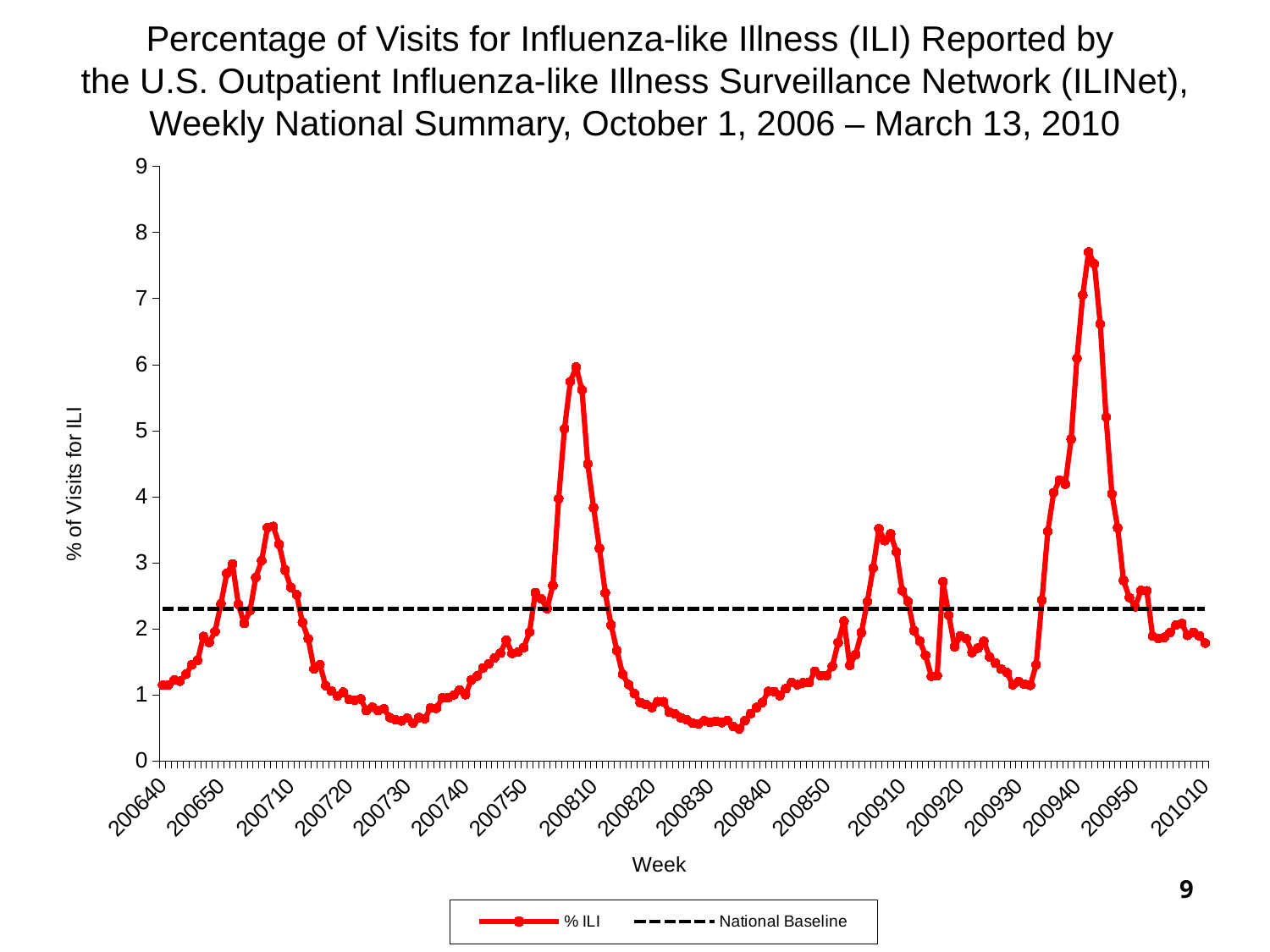
What kind of chart is shown on the slide? line chart What is the title of the vertical axis? % of Visits for ILI Around which x-axis week label does the % ILI line reach its highest value? 200940 Is the peak of the % ILI line near week 200710 greater or less than 4? less Around which x-axis week label does the % ILI line reach its lowest value? 200830 Between week 200810 and week 200830, does the % ILI line rise or fall? fall Which peak of the % ILI line is higher: the one near week 200810 or the one near week 200940? the one near week 200940 What are the two entries in the chart's legend? % ILI and National Baseline Is the peak of the % ILI line near week 200810 greater or less than 5? greater How many series does the legend list? 2 Is the highest peak of the % ILI line, near week 200940, greater or less than 7? greater